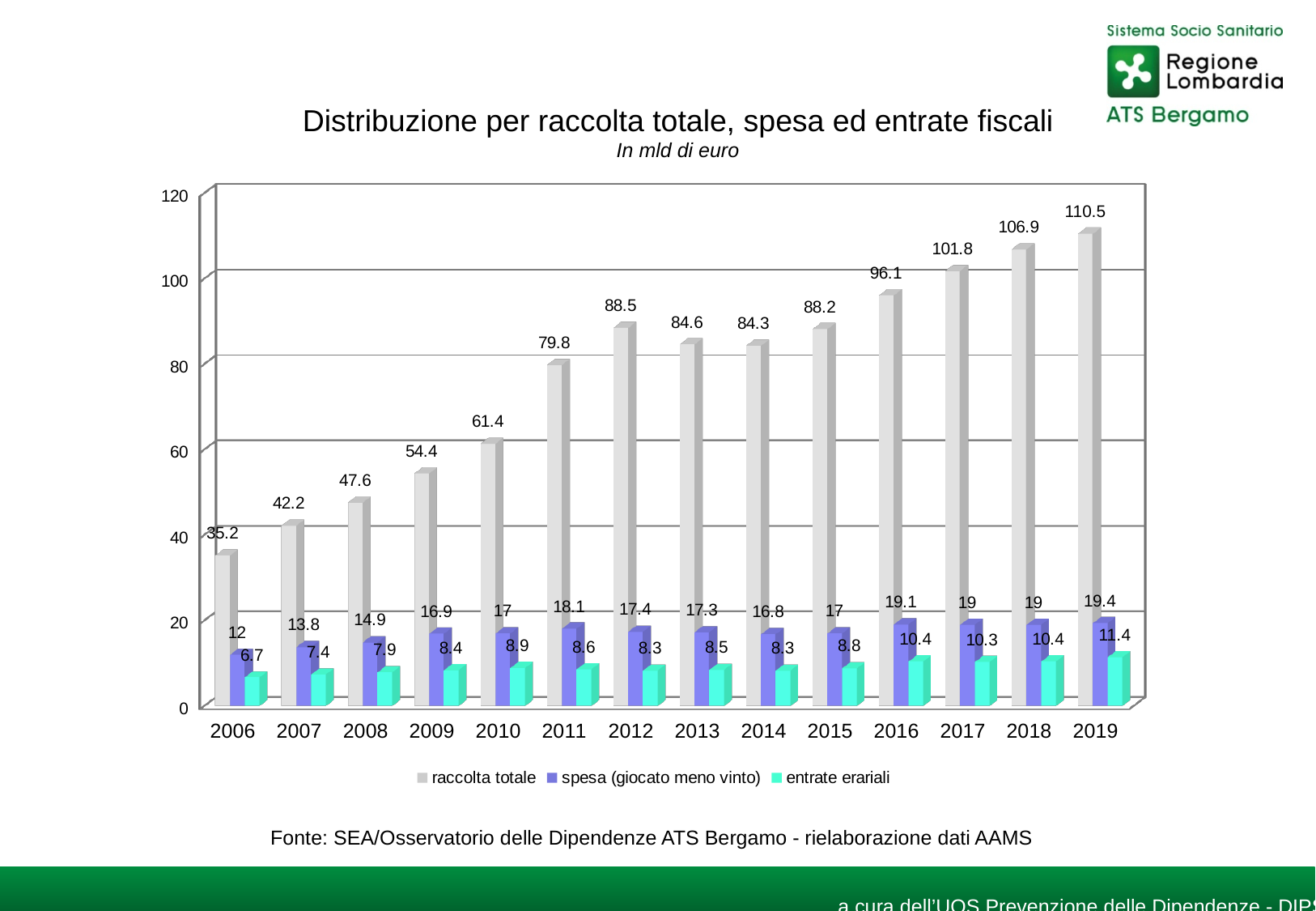
Is spesa (giocato meno vinto) larger in 2016 or in 2014? 2016 What unit is stated in the chart subtitle? mld di euro Which year has the highest entrate erariali? 2019 What is the value of entrate erariali in 2006? 6.7 How many series does the legend list? 3 What kind of chart is shown on the slide? bar chart What is the value of spesa (giocato meno vinto) in 2011? 18.1 Is the raccolta totale value for 2012 greater or less than 80? greater How many years are shown on the x axis? 14 What is the value of raccolta totale in 2019? 110.5 What is the difference between raccolta totale in 2019 and in 2006? 75.3 Which year has the lowest raccolta totale? 2006